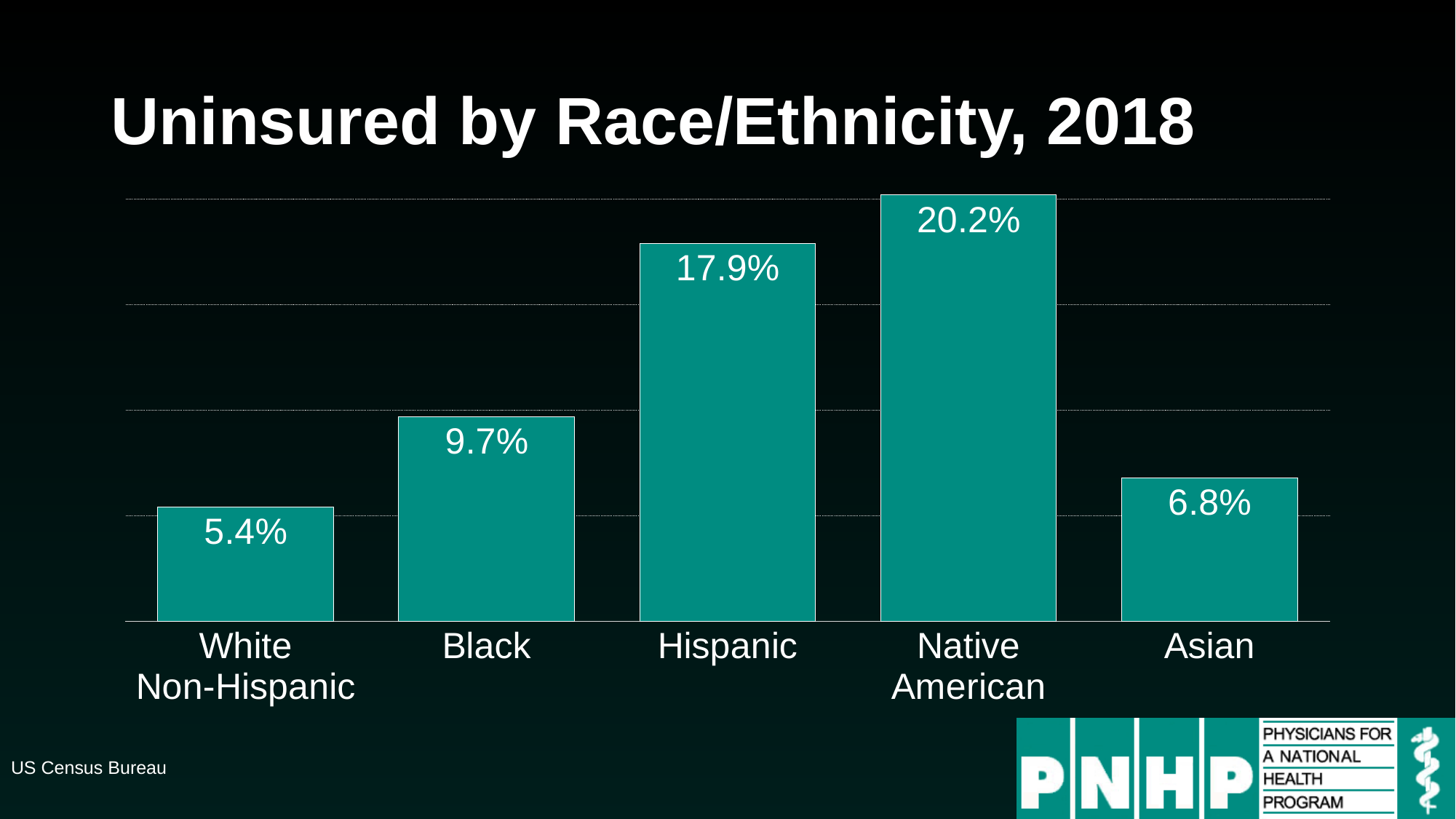
What is the uninsured rate for Asian people? 6.8% What is the title of the chart? Uninsured by Race/Ethnicity, 2018 Which race/ethnicity group has the highest uninsured rate? Native American What is the difference in uninsured rate between Native American and Hispanic people? 2.3% What is the uninsured rate for Hispanic people? 17.9% What is the uninsured rate for White Non-Hispanic people? 5.4% What source is cited for the chart data? US Census Bureau What is the difference in uninsured rate between Black and White Non-Hispanic people? 4.3% Which group has a higher uninsured rate, Black or Asian? Black What type of chart is shown on the slide? Bar chart Which race/ethnicity group has the lowest uninsured rate? White Non-Hispanic How many race/ethnicity categories are shown in the chart? 5